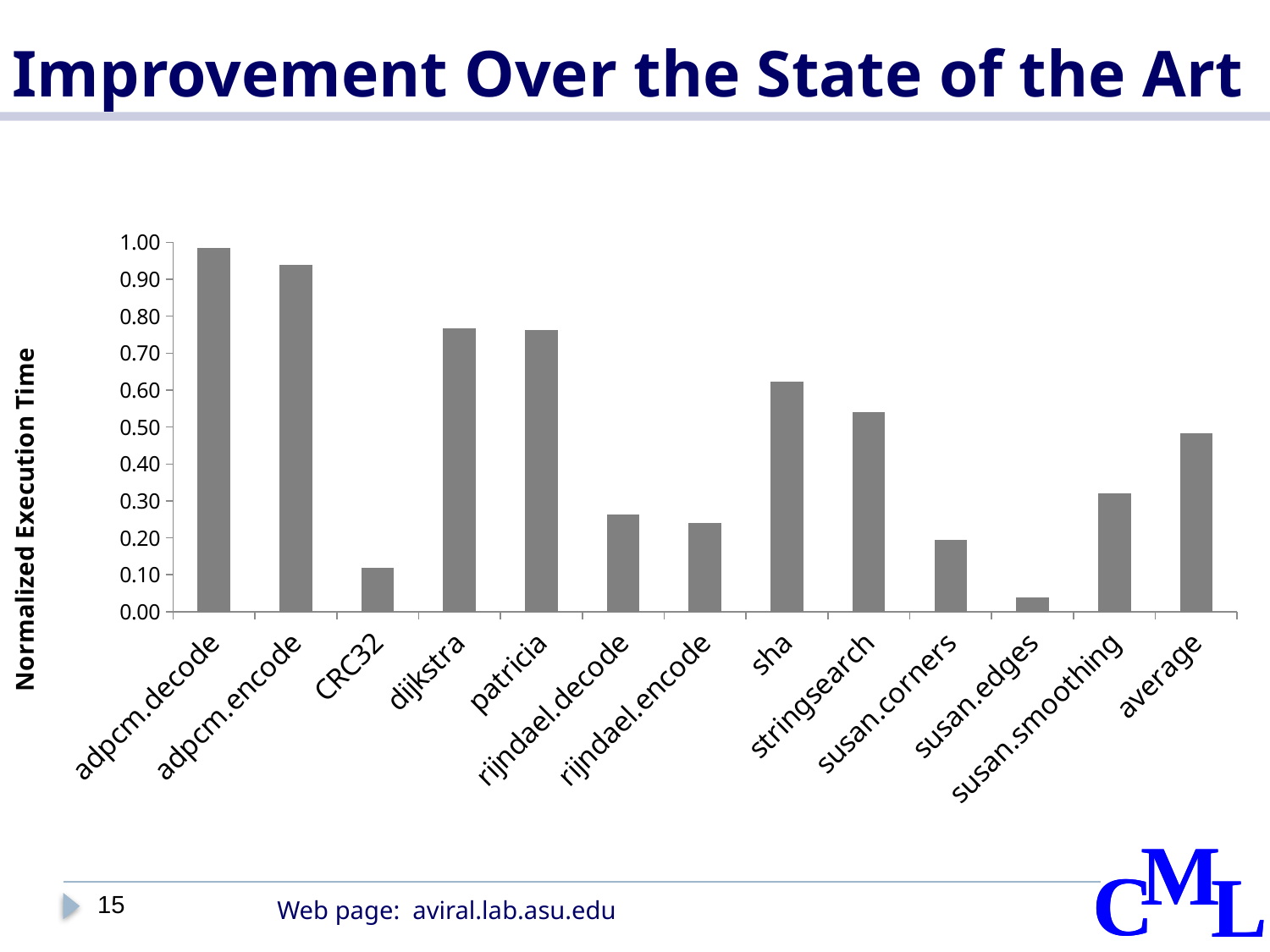
Which category has the highest normalized execution time? adpcm.decode What kind of chart is shown on the slide? bar chart Which has a larger normalized execution time, sha or stringsearch? sha Is the value for adpcm.encode greater or less than 0.90? greater Which has a larger normalized execution time, susan.corners or susan.smoothing? susan.smoothing What is the label of the y axis? Normalized Execution Time Is the value for average greater or less than 0.50? less Is the value for susan.smoothing greater or less than 0.30? greater Which category has the lowest normalized execution time? susan.edges How many benchmark categories are plotted along the x axis? 13